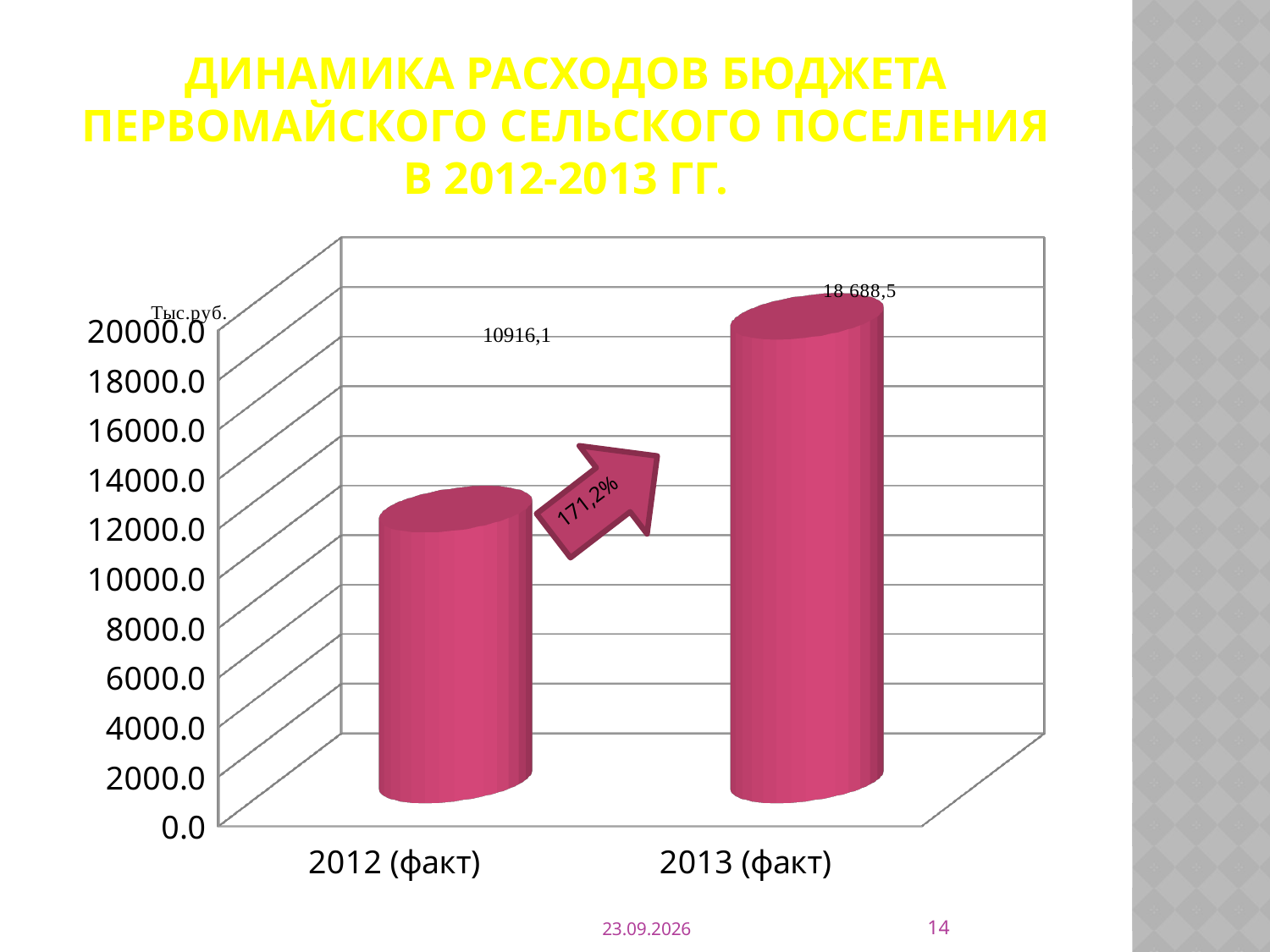
Is the value for 2012 (факт) greater or less than 12000.0? less Do the values rise or fall from 2012 (факт) to 2013 (факт)? rise How many categories are shown on the x axis? 2 What is the difference between the values for 2013 (факт) and 2012 (факт)? 7772,4 What is the value for 2013 (факт)? 18 688,5 What kind of chart is shown on the slide? bar chart What percentage is written on the arrow between the two bars? 171,2% What is the value for 2012 (факт)? 10916,1 Is the value for 2013 (факт) greater or less than 16000.0? greater Which category has the lowest value? 2012 (факт) Which category has the highest value? 2013 (факт) Which is larger, the value for 2012 (факт) or the value for 2013 (факт)? 2013 (факт)